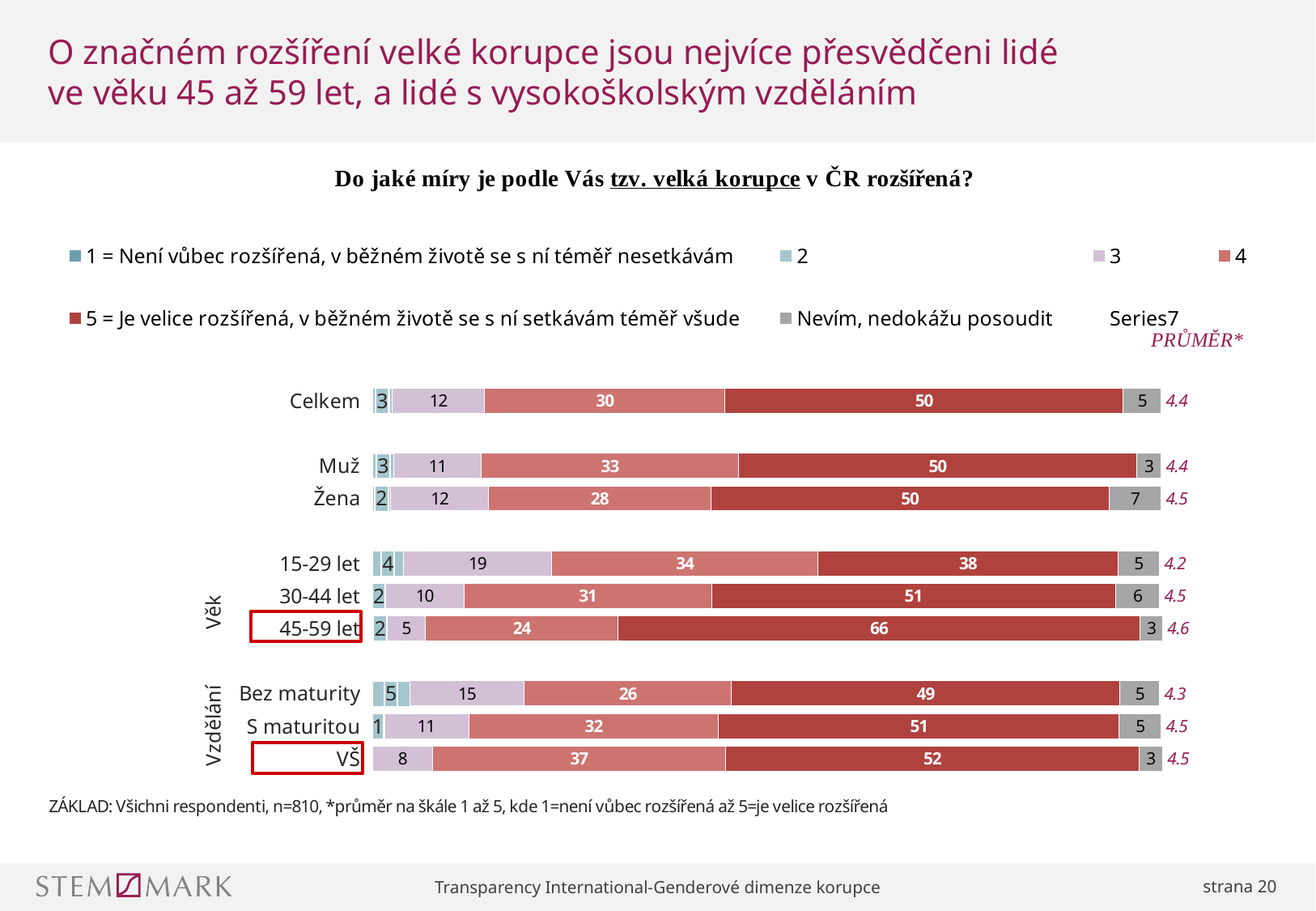
How many categories (bars) are shown in the chart? 9 Which has a larger "3" segment value: 15-29 let or 45-59 let? 15-29 let Which category has the lowest PRŮMĚR (average) value? 15-29 let How many series does the legend list? 7 What is the difference between the "5" segment values for 45-59 let and 15-29 let? 28 What is the PRŮMĚR (average) shown for the 15-29 let category? 4.2 Which category has the highest value for the "5 = Je velice rozšířená" segment? 45-59 let What is the value of the "Nevím, nedokážu posoudit" segment for Žena? 7 What is the value of the "4" segment for the VŠ category? 37 Which two categories are highlighted with red boxes on the slide? 45-59 let and VŠ What kind of chart is shown on the slide? Stacked bar chart What is the value of the "5 = Je velice rozšířená" segment for the 45-59 let category? 66